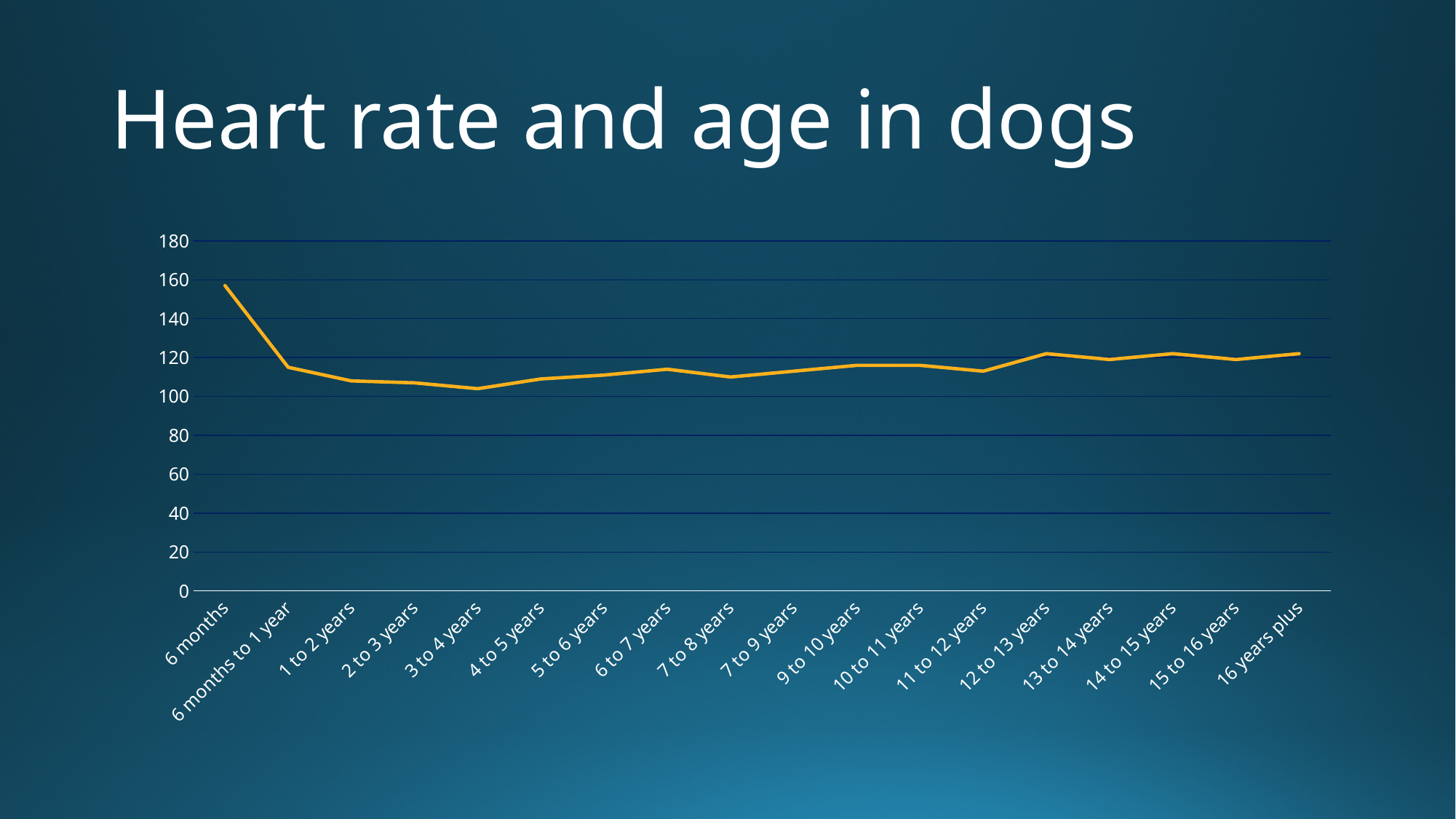
What is the title of the chart? Heart rate and age in dogs How many age categories are plotted along the x axis? 18 Is the value for 3 to 4 years greater or less than 120? less Which age category has the lowest value? 3 to 4 years Does the line rise or fall from 6 months to 3 to 4 years? fall Is the value for 6 months greater or less than 140? greater Which is larger, the value for 6 months or the value for 16 years plus? 6 months Is the value for 16 years plus greater or less than 140? less Which is larger, the value for 3 to 4 years or the value for 12 to 13 years? 12 to 13 years What kind of chart is shown on the slide? line chart Which age category has the highest value? 6 months